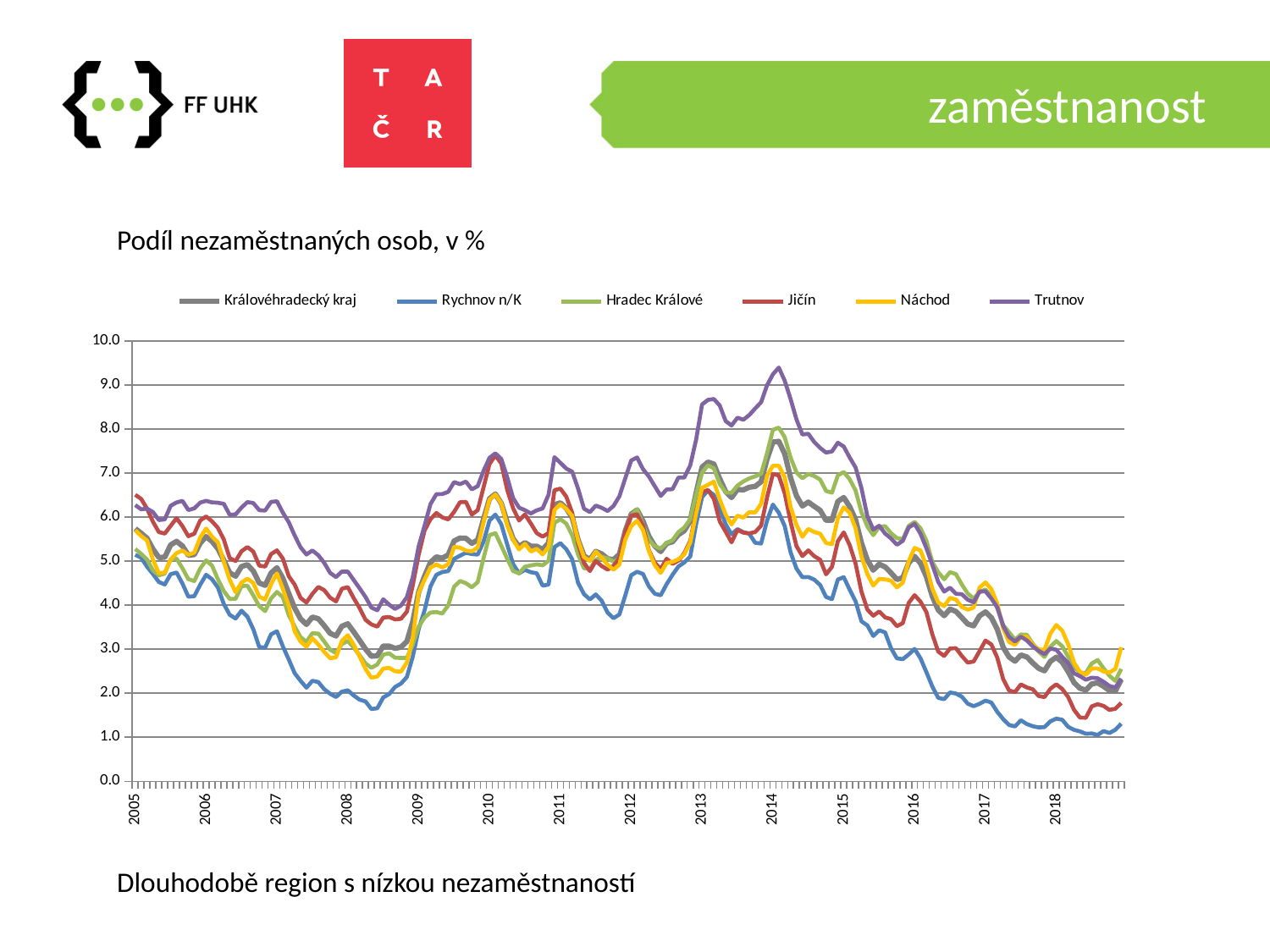
What is the title of the chart? Podíl nezaměstnaných osob, v % At the 2014 peak, which is larger: the value for Trutnov or the value for Rychnov n/K? Trutnov Which series reaches the highest value on the chart, at its peak in 2014? Trutnov Do the values generally rise or fall between 2014 and 2018? fall What is the first year and the last year labelled on the x axis? 2005 and 2018 Which series is the lowest line for most of the period shown? Rychnov n/K Is the value for Jičín at the start of 2005 greater or less than 6.0? greater What colour is the Trutnov line in the chart? purple What kind of chart is shown on the slide? line chart How many series does the legend of the chart list? 6 Is the peak value for Trutnov in 2014 greater or less than 9.0? greater Is the value for Rychnov n/K at the end of 2018 greater or less than 2.0? less